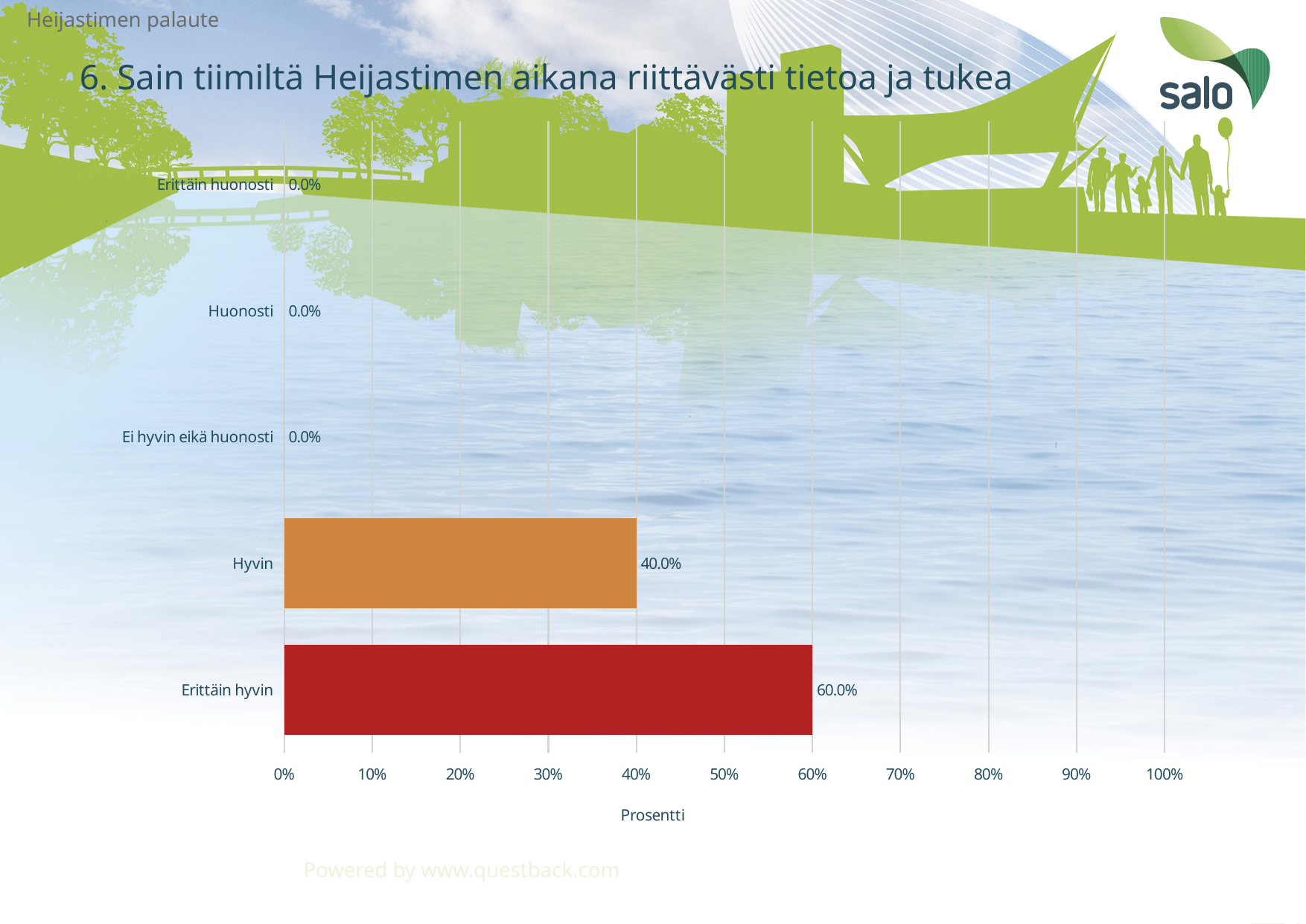
Which category has the highest value? Erittäin hyvin What is the value for "Huonosti"? 0.0% Which is larger, the value for "Hyvin" or the value for "Erittäin hyvin"? Erittäin hyvin What is the value for "Ei hyvin eikä huonosti"? 0.0% What is the value for "Hyvin"? 40.0% What kind of chart is shown on the slide? Bar chart Is the value for "Erittäin hyvin" greater or less than 50%? greater How many categories have a value of 0.0%? 3 What is the value for "Erittäin hyvin"? 60.0% What is the label of the horizontal axis? Prosentti What is the difference between the values for "Erittäin hyvin" and "Hyvin"? 20.0% How many categories are shown on the chart? 5